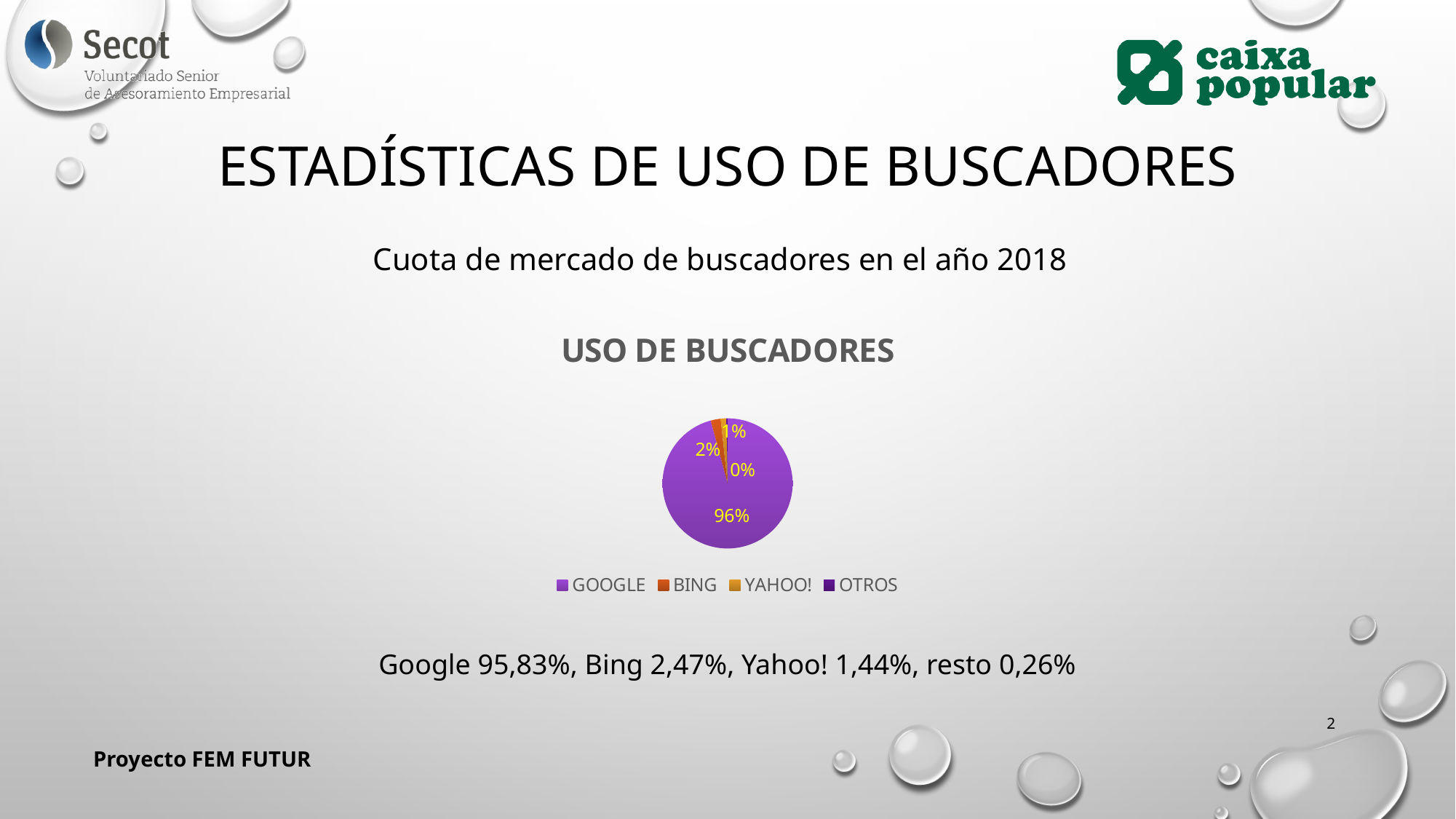
What share of the pie does YAHOO! have according to the data label? 1% Which legend entry is shown in the lighter purple colour that fills most of the pie? GOOGLE Which slice is larger, BING or YAHOO!? BING What share of the pie does BING have according to the data label? 2% Which category has the smallest slice of the pie? OTROS Which category has the largest slice of the pie? GOOGLE What share of the pie does OTROS have according to the data label? 0% How many categories does the legend of the pie chart list? 4 What kind of chart is shown on the slide? pie chart What is the difference in percentage points between the GOOGLE and BING data labels? 94% What is the title of the chart? USO DE BUSCADORES